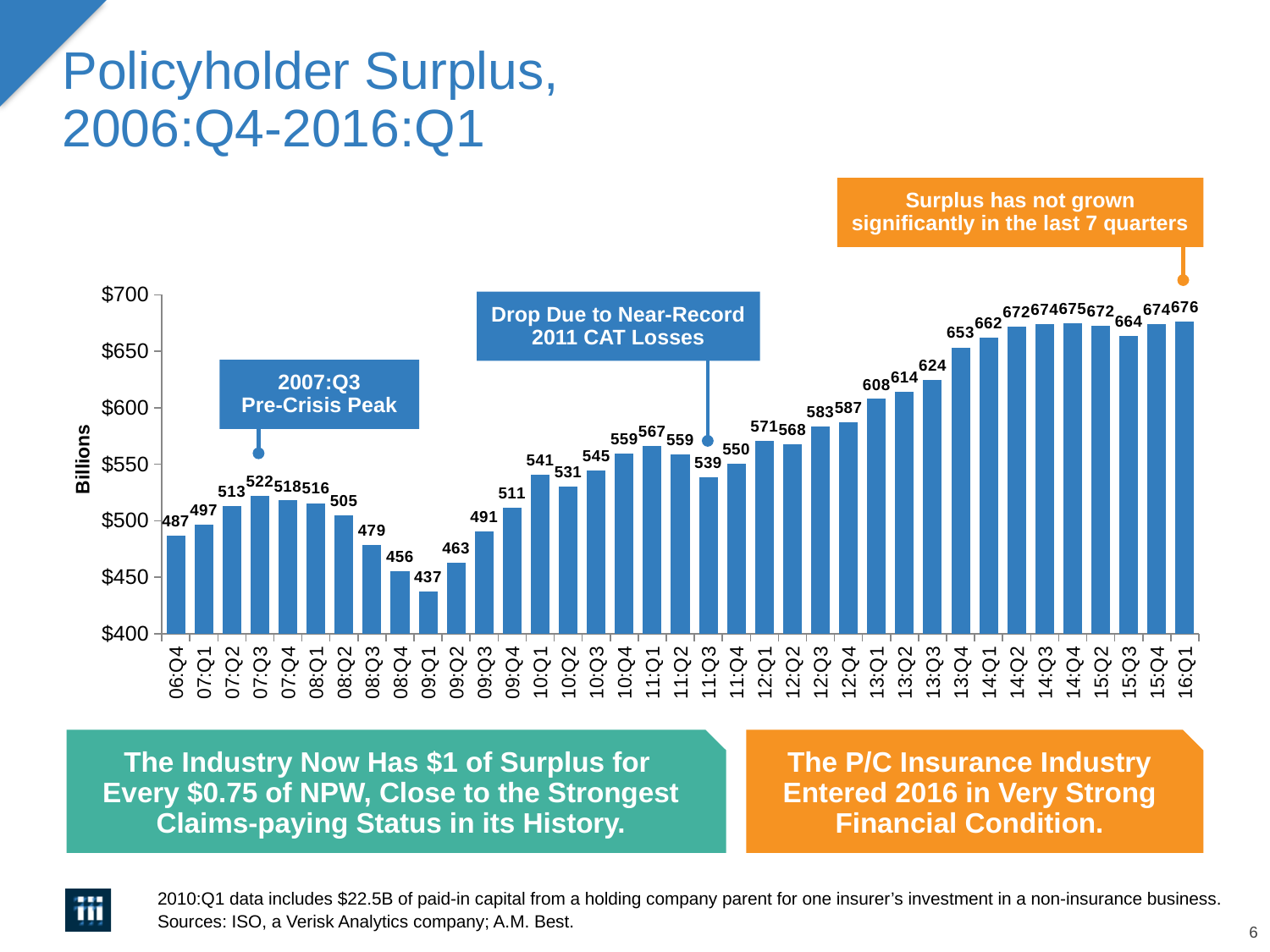
What kind of chart is shown on the slide? bar chart What is the difference between the surplus in 16:Q1 and the surplus in 09:Q1? 239 Which is larger, the surplus in 11:Q1 or the surplus in 11:Q3? 11:Q1 What is the policyholder surplus value for 07:Q3? 522 What is the policyholder surplus value for 09:Q1? 437 Is the value for 13:Q4 greater or less than $650? greater What is the label on the vertical axis of the chart? Billions What is the policyholder surplus value for 11:Q3? 539 Which quarter has the lowest policyholder surplus? 09:Q1 What is the difference between the surplus in 07:Q3 and the surplus in 06:Q4? 35 What is the policyholder surplus value for 16:Q1? 676 Which quarter has the highest policyholder surplus? 16:Q1